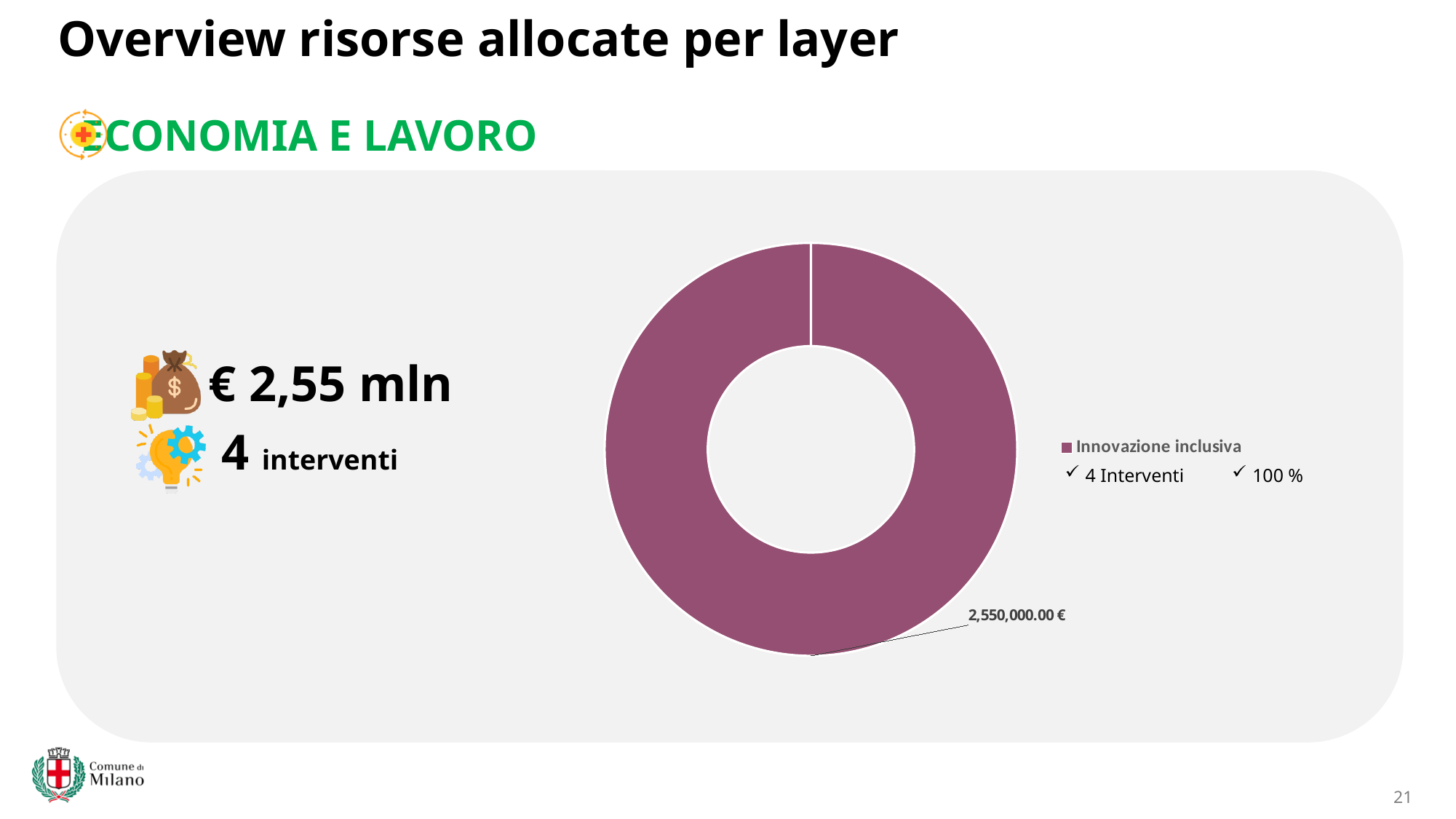
How many entries does the chart legend list? 1 How many interventi are listed for Innovazione inclusiva next to the legend? 4 Interventi What share of the chart does Innovazione inclusiva represent? 100 % What kind of chart is shown on the slide? Doughnut chart How many categories does the chart contain? 1 What is the name of the only category in the chart legend? Innovazione inclusiva What value is shown for Innovazione inclusiva in the chart? 2,550,000.00 € What colour is the Innovazione inclusiva segment of the chart? Purple Is the value for Innovazione inclusiva greater or less than 2,000,000 €? greater